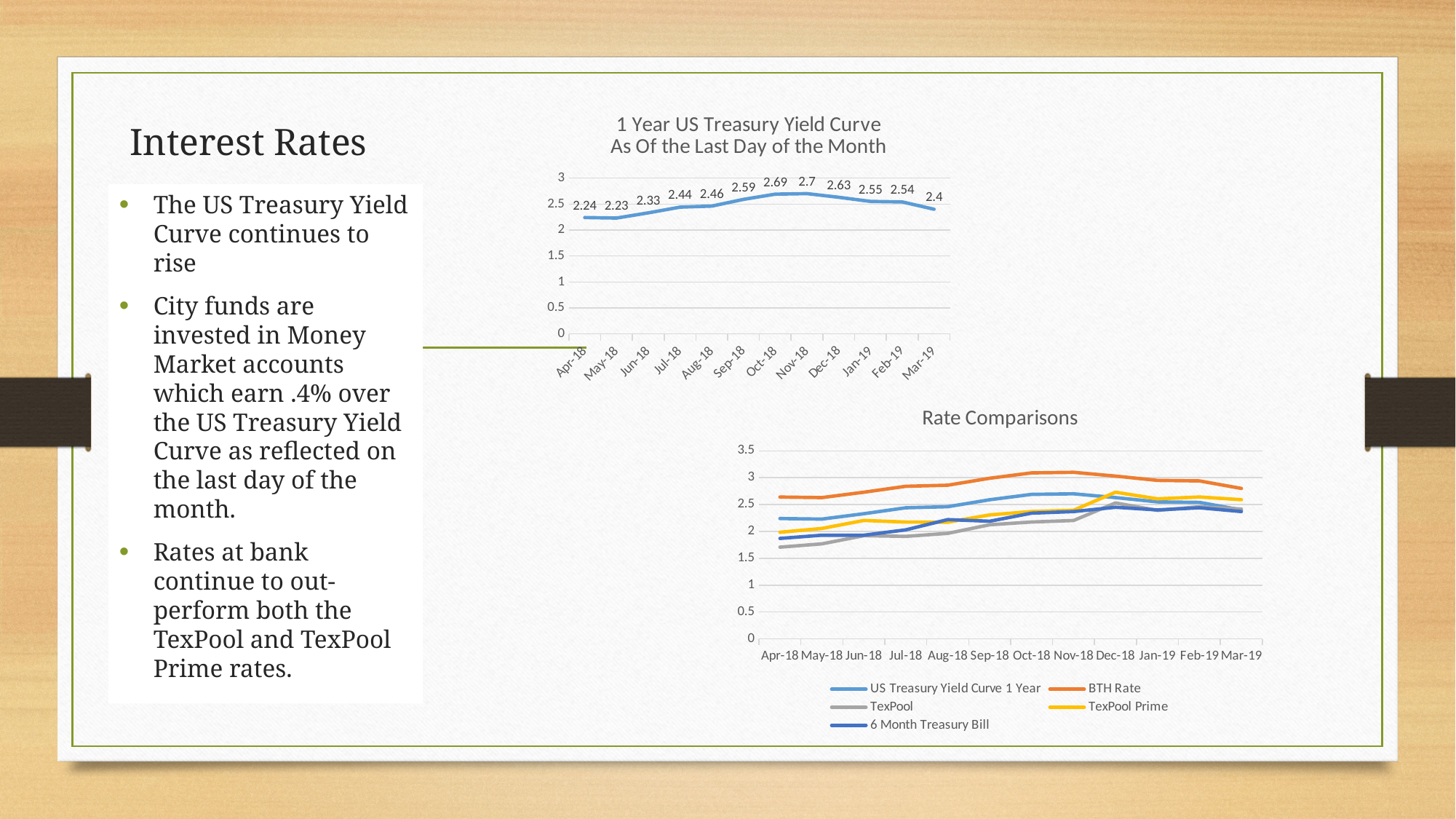
In the 'Rate Comparisons' chart, what colour is the BTH Rate line? Orange In the '1 Year US Treasury Yield Curve' chart, what is the value for Oct-18? 2.69 In the '1 Year US Treasury Yield Curve' chart, which month has the lowest value? May-18 In the 'Rate Comparisons' chart, which is higher in Jul-18: the BTH Rate or TexPool? BTH Rate What kind of chart is the '1 Year US Treasury Yield Curve' chart? Line chart In the '1 Year US Treasury Yield Curve' chart, which month has the highest value? Nov-18 In the 'Rate Comparisons' chart, how many series does the legend list? 5 In the '1 Year US Treasury Yield Curve' chart, how many months are plotted? 12 In the '1 Year US Treasury Yield Curve' chart, do the values rise or fall from Apr-18 to Nov-18? Rise In the '1 Year US Treasury Yield Curve' chart, what is the difference between the Nov-18 value and the Apr-18 value? 0.46 In the '1 Year US Treasury Yield Curve' chart, what is the value for Mar-19? 2.4 In the 'Rate Comparisons' chart, is the TexPool value for Apr-18 greater or less than 2? less